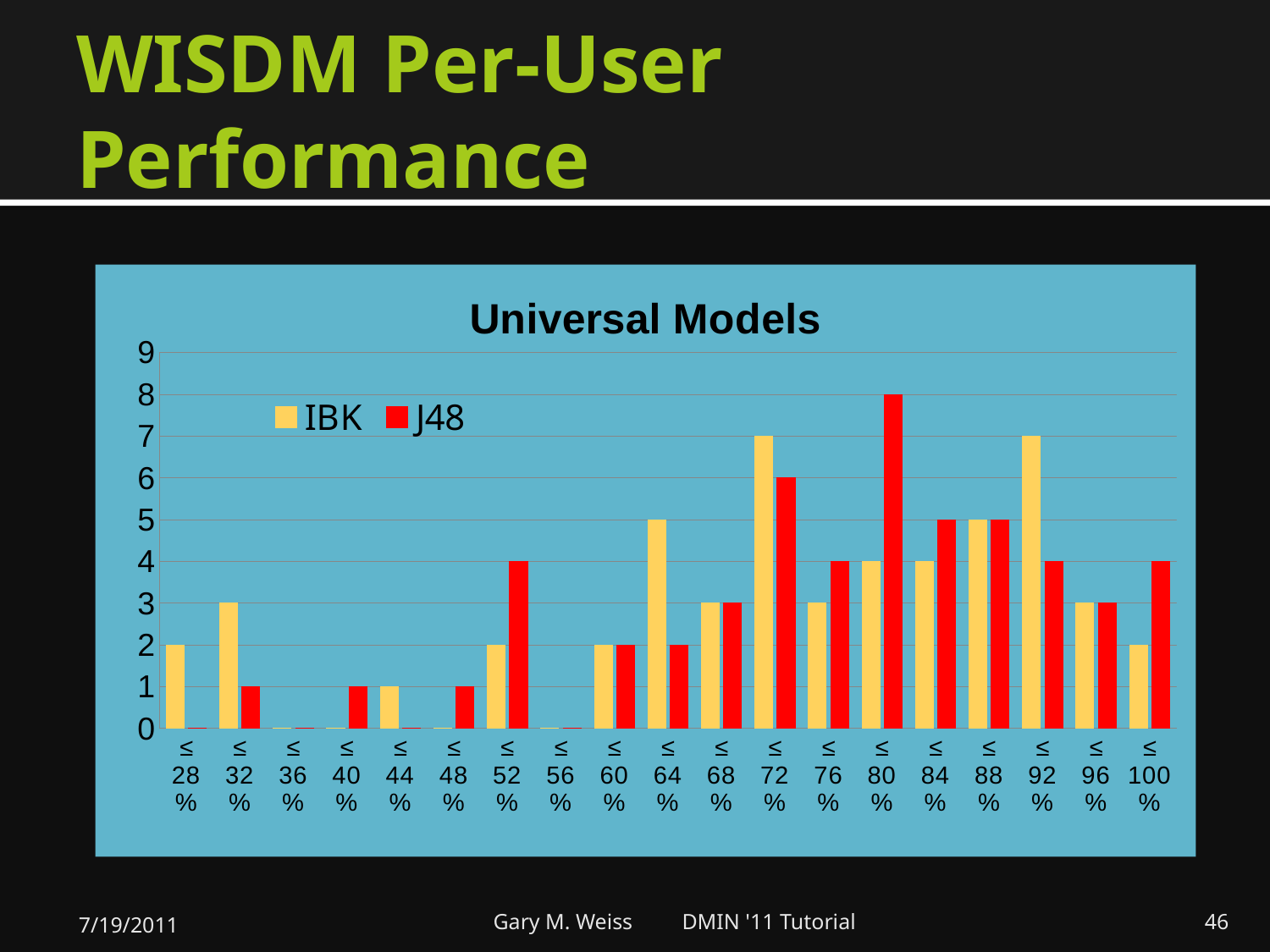
How many categories are shown on the x axis? 19 In the ≤52% category, which series has the larger value, IBK or J48? J48 What is the J48 value for the ≤80% category? 8 How many series does the legend list? 2 Which category has the highest J48 value? ≤80% What is the difference between the J48 and IBK values in the ≤80% category? 4 What is the IBK value for the ≤64% category? 5 Is the IBK value for ≤72% greater or less than 5? greater What colour represents the J48 series? red What is the title of the chart? Universal Models What kind of chart is shown on the slide? bar chart In the ≤92% category, which series has the larger value, IBK or J48? IBK